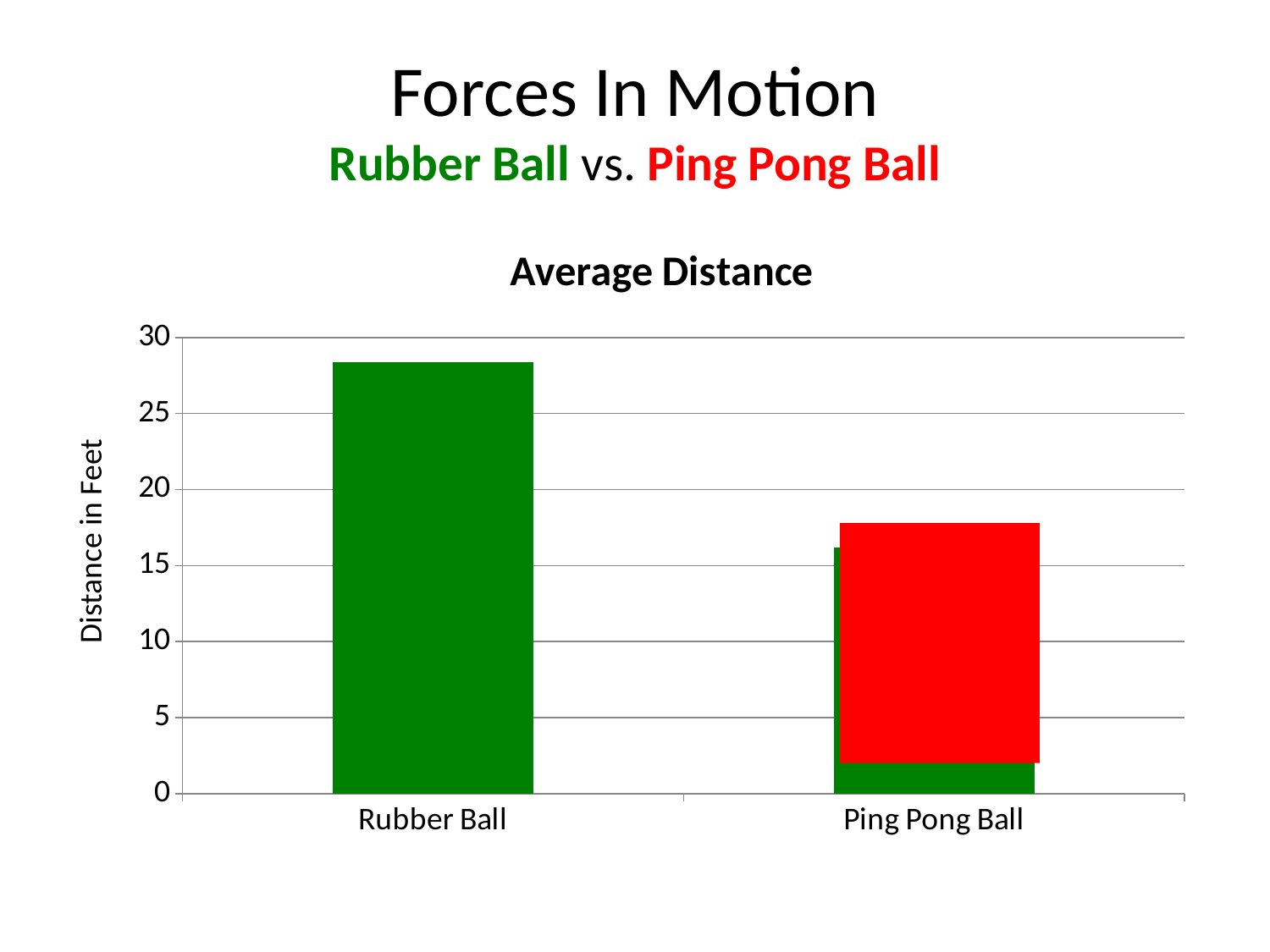
What is the title of the chart? Average Distance Is the value for Rubber Ball greater or less than 30? less How many categories are shown on the x axis of the chart? 2 Is the value for Rubber Ball greater or less than 25? greater Which category has the highest average distance? Rubber Ball Is the value for Ping Pong Ball greater or less than 20? less What is the label on the vertical axis of the chart? Distance in Feet Which has a larger average distance, the Rubber Ball or the Ping Pong Ball? Rubber Ball Which category has the lowest average distance? Ping Pong Ball Do the values rise or fall moving from Rubber Ball to Ping Pong Ball along the x axis? fall What kind of chart is shown on the slide? bar chart